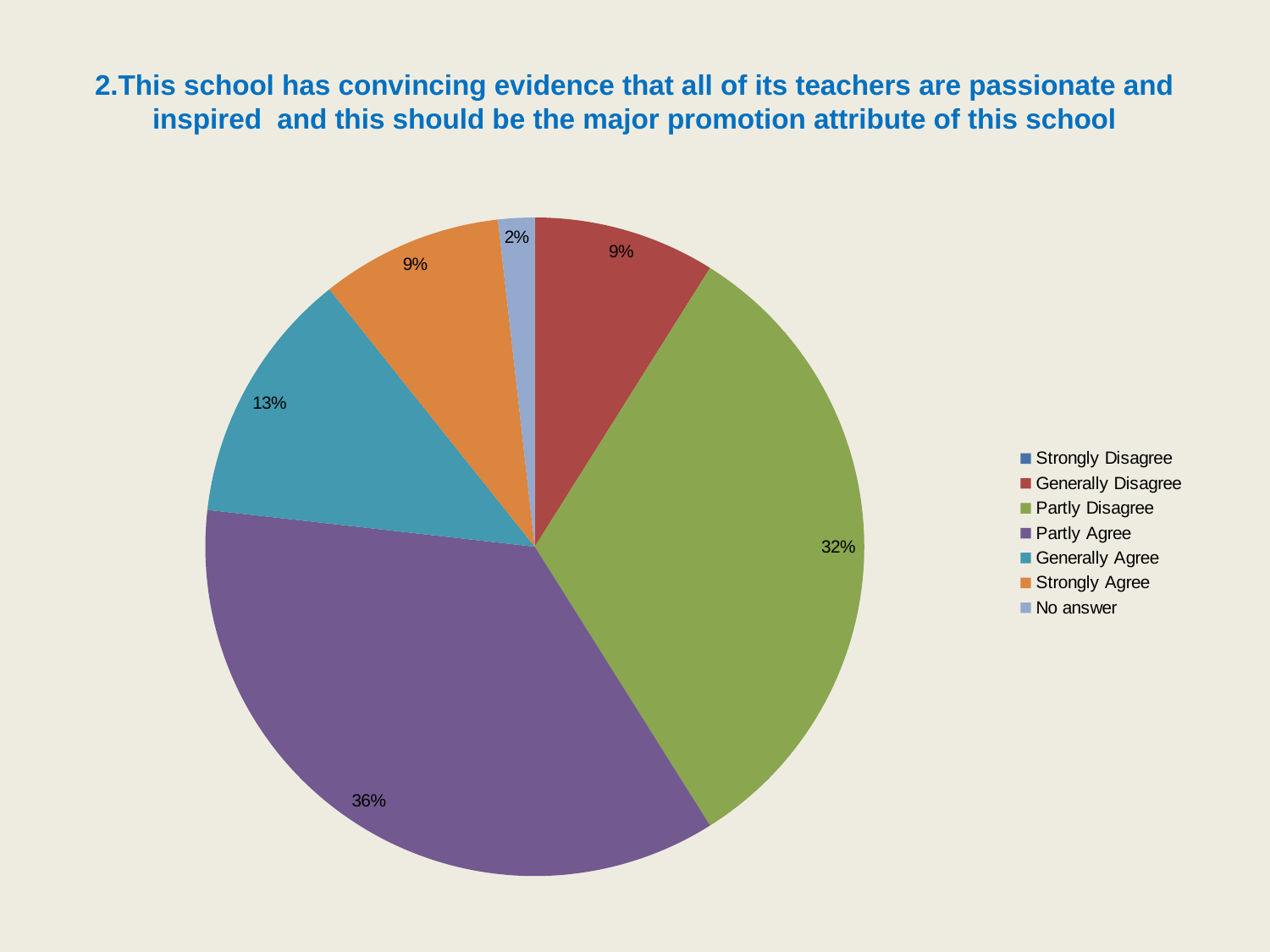
What is the difference in percentage points between Partly Agree and Partly Disagree? 4 What percentage of respondents chose Partly Disagree? 32% What percentage of respondents chose Generally Disagree? 9% What percentage of respondents chose No answer? 2% What colour is the Partly Agree slice? purple Which labelled slice has the smallest share of the pie? No answer What percentage of respondents chose Partly Agree? 36% What kind of chart is shown on the slide? pie chart Which response category has the largest share of the pie? Partly Agree What percentage of respondents chose Generally Agree? 13% How many entries does the legend list? 7 Which is larger, the share for Generally Agree or the share for Strongly Agree? Generally Agree